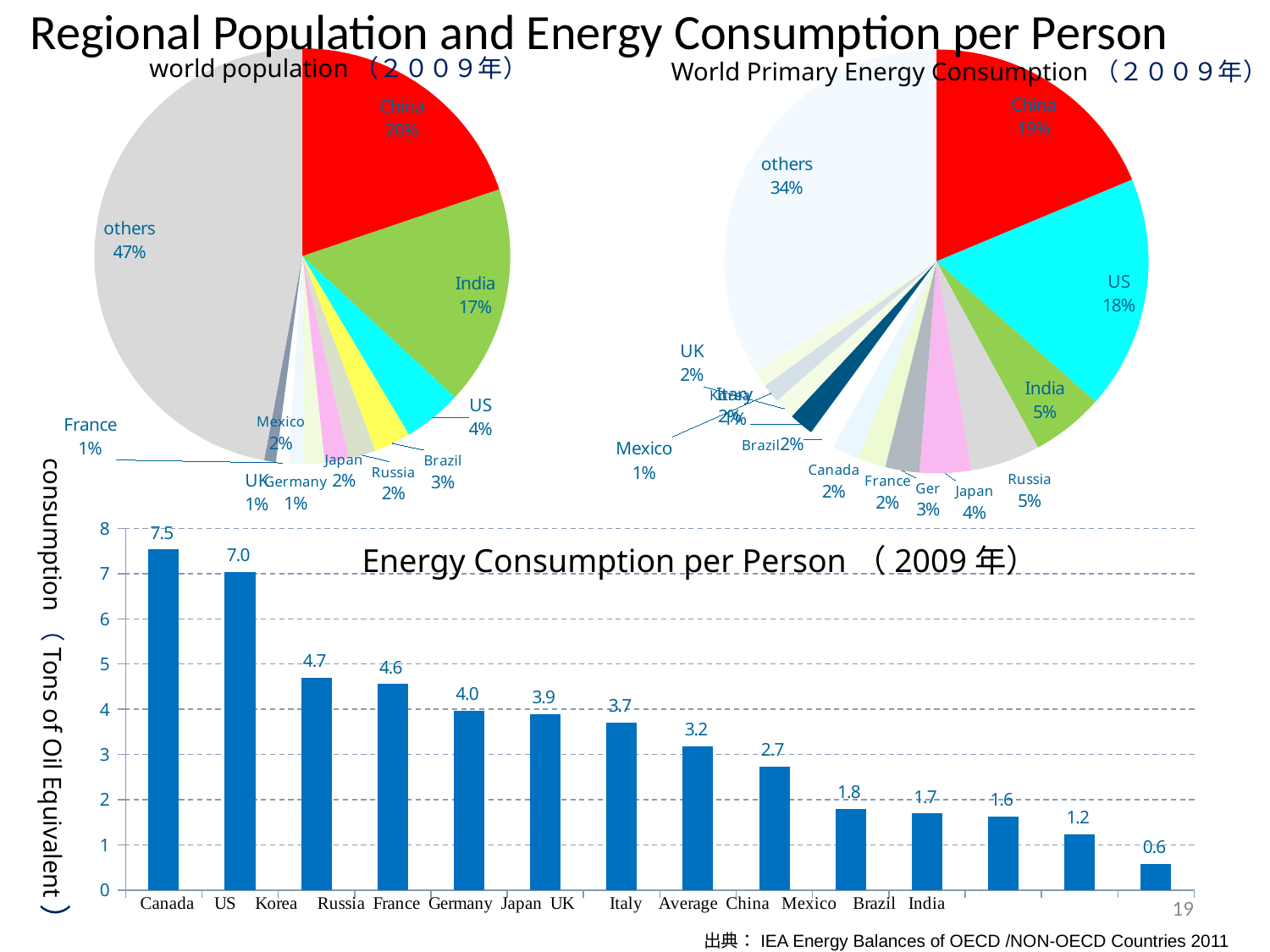
In the Energy Consumption per Person bar chart, what is the value for the US? 7.0 In the Energy Consumption per Person bar chart, what is the value for Canada? 7.5 In the Energy Consumption per Person bar chart, which category has the highest value? Canada In the World Primary Energy Consumption pie chart, what share does the US have? 18% In the Energy Consumption per Person bar chart, what is the lowest value shown? 0.6 In the world population pie chart, what share does China have? 20% In the Energy Consumption per Person bar chart, what is the difference between the values for Canada and the US? 0.5 What kind of chart is the Energy Consumption per Person chart at the bottom of the slide? Bar chart In the World Primary Energy Consumption pie chart, what share does India have? 5%